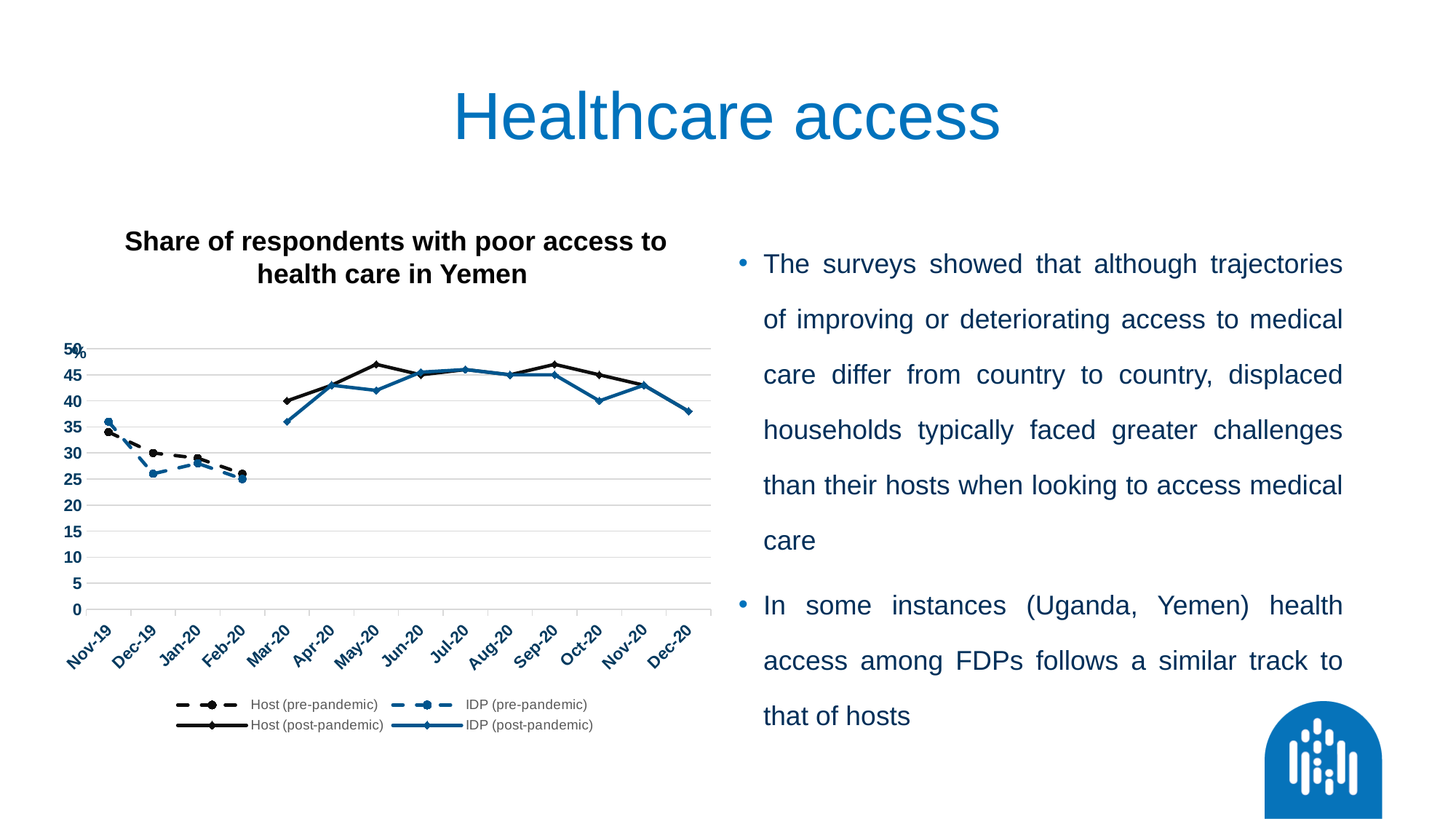
Is the value for IDP (pre-pandemic) in Feb-20 greater or less than 30? less Do the pre-pandemic series rise or fall from Nov-19 to Feb-20? Fall How many series does the chart legend list? 4 In Dec-19, which series has the higher value: Host (pre-pandemic) or IDP (pre-pandemic)? Host (pre-pandemic) What is the title of the chart? Share of respondents with poor access to health care in Yemen How many months are labelled along the x axis of the chart? 14 What kind of chart is shown on the slide? Line chart In Oct-20, which series has the higher value: Host (post-pandemic) or IDP (post-pandemic)? Host (post-pandemic) Is the value for IDP (post-pandemic) in Dec-20 greater or less than 40? less In which month is the IDP (post-pandemic) series at its lowest? Mar-20 Is the value for Host (post-pandemic) in Sep-20 greater or less than 45? greater